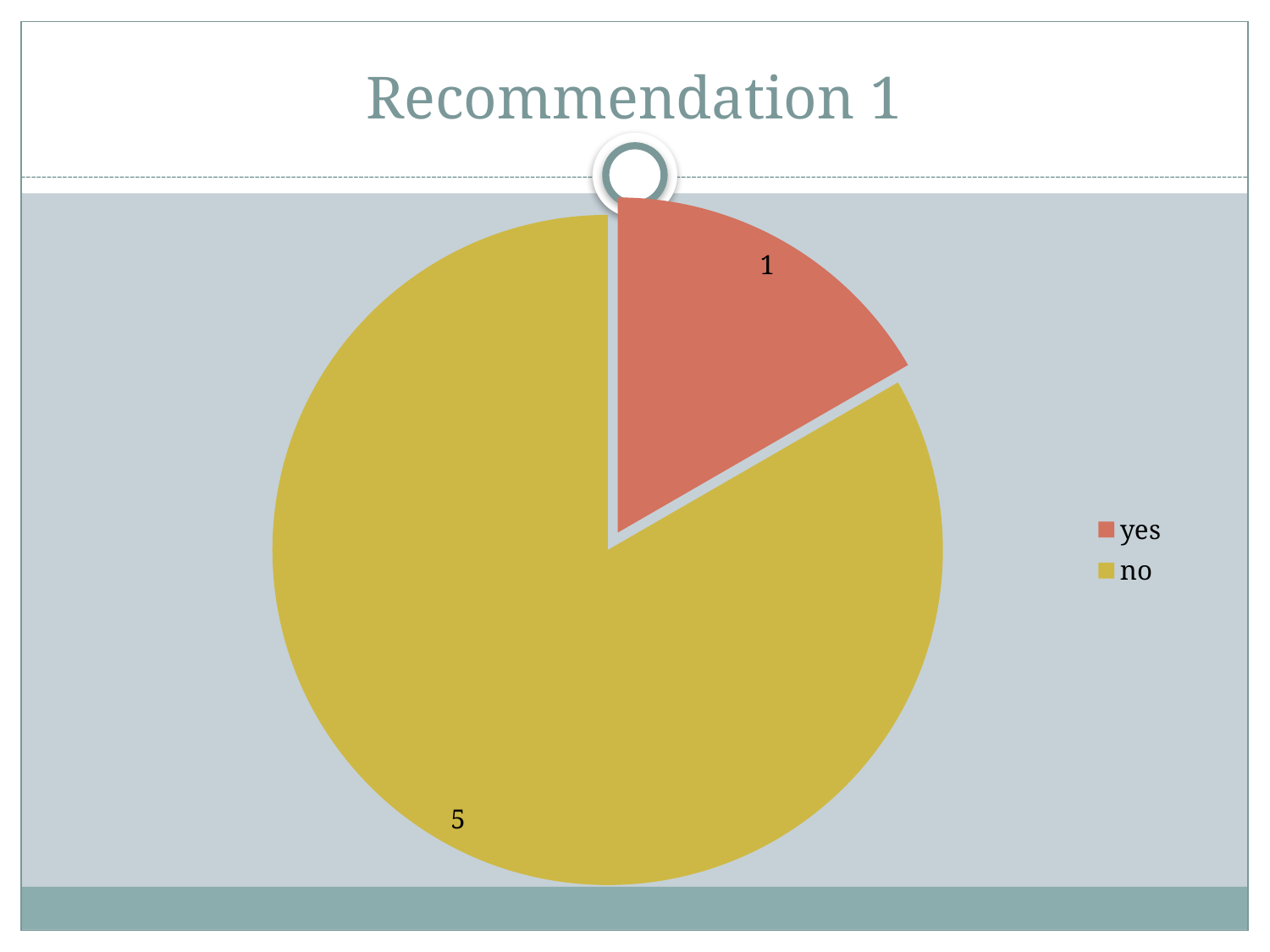
How many slices does the pie chart have? 2 What is the title of the slide containing the chart? Recommendation 1 Which is larger, the value for "yes" or the value for "no"? no What is the value for "no"? 5 What type of chart is shown on the slide? pie chart What is the value for "yes"? 1 What colour is the "no" slice? yellow What is the difference between the values for "no" and "yes"? 4 Which category has the smallest slice? yes What is the total of all slices in the pie chart? 6 Which category has the largest slice? no How many entries does the legend list? 2